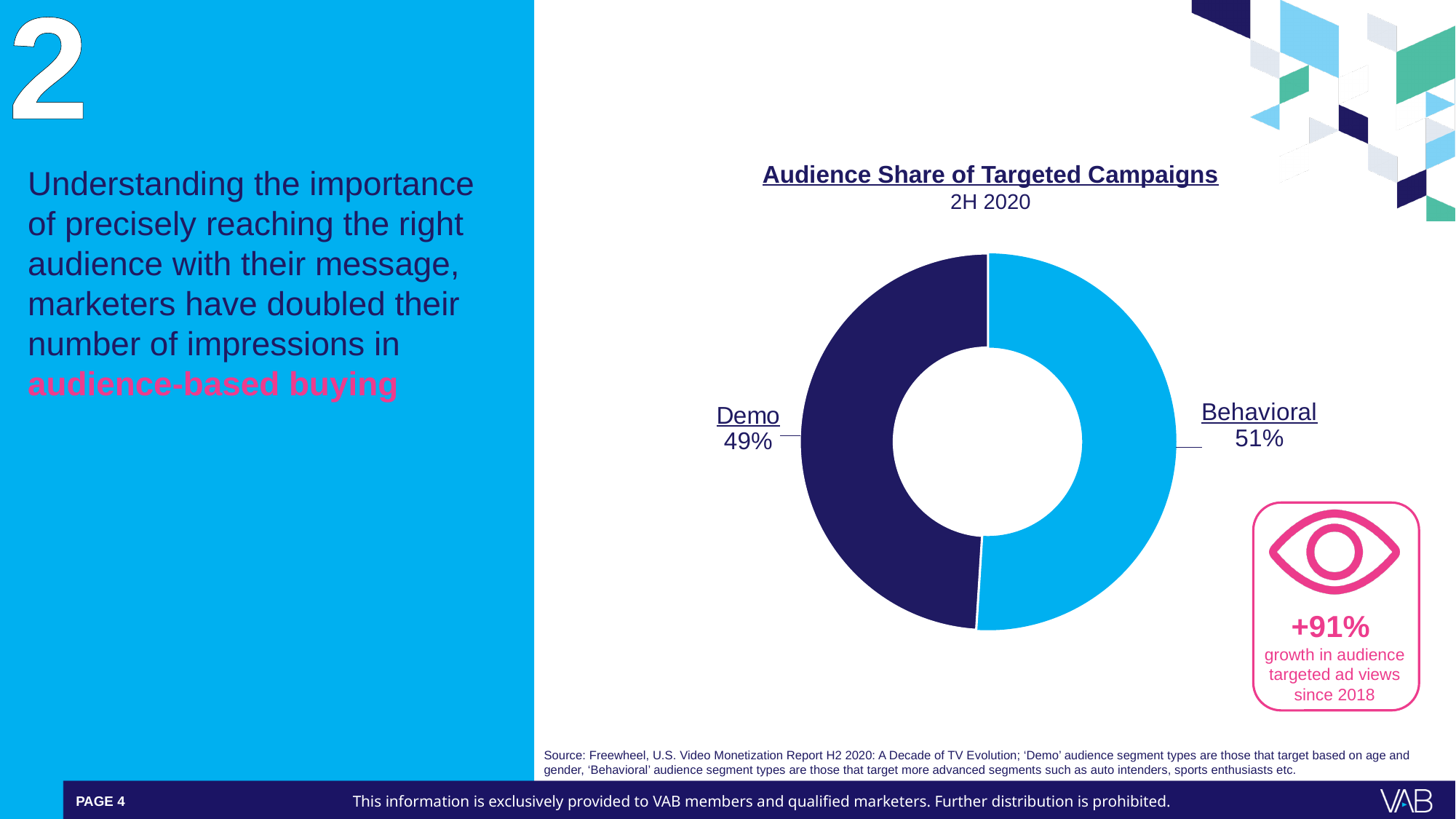
What is the title of the chart on the slide? Audience Share of Targeted Campaigns What is the value for Behavioral in the Audience Share of Targeted Campaigns chart? 51% Which category has the smallest share in the Audience Share of Targeted Campaigns chart? Demo What kind of chart is used to show Audience Share of Targeted Campaigns? Pie chart (donut) What time period does the Audience Share of Targeted Campaigns chart cover? 2H 2020 Which category has the largest share in the Audience Share of Targeted Campaigns chart? Behavioral How many categories are shown in the Audience Share of Targeted Campaigns chart? 2 What is the value for Demo in the Audience Share of Targeted Campaigns chart? 49% What share of the Audience Share of Targeted Campaigns pie does Behavioral represent? 51% In the Audience Share of Targeted Campaigns chart, which is larger, Demo or Behavioral? Behavioral What is the difference between the Behavioral and Demo shares in the Audience Share of Targeted Campaigns chart? 2%